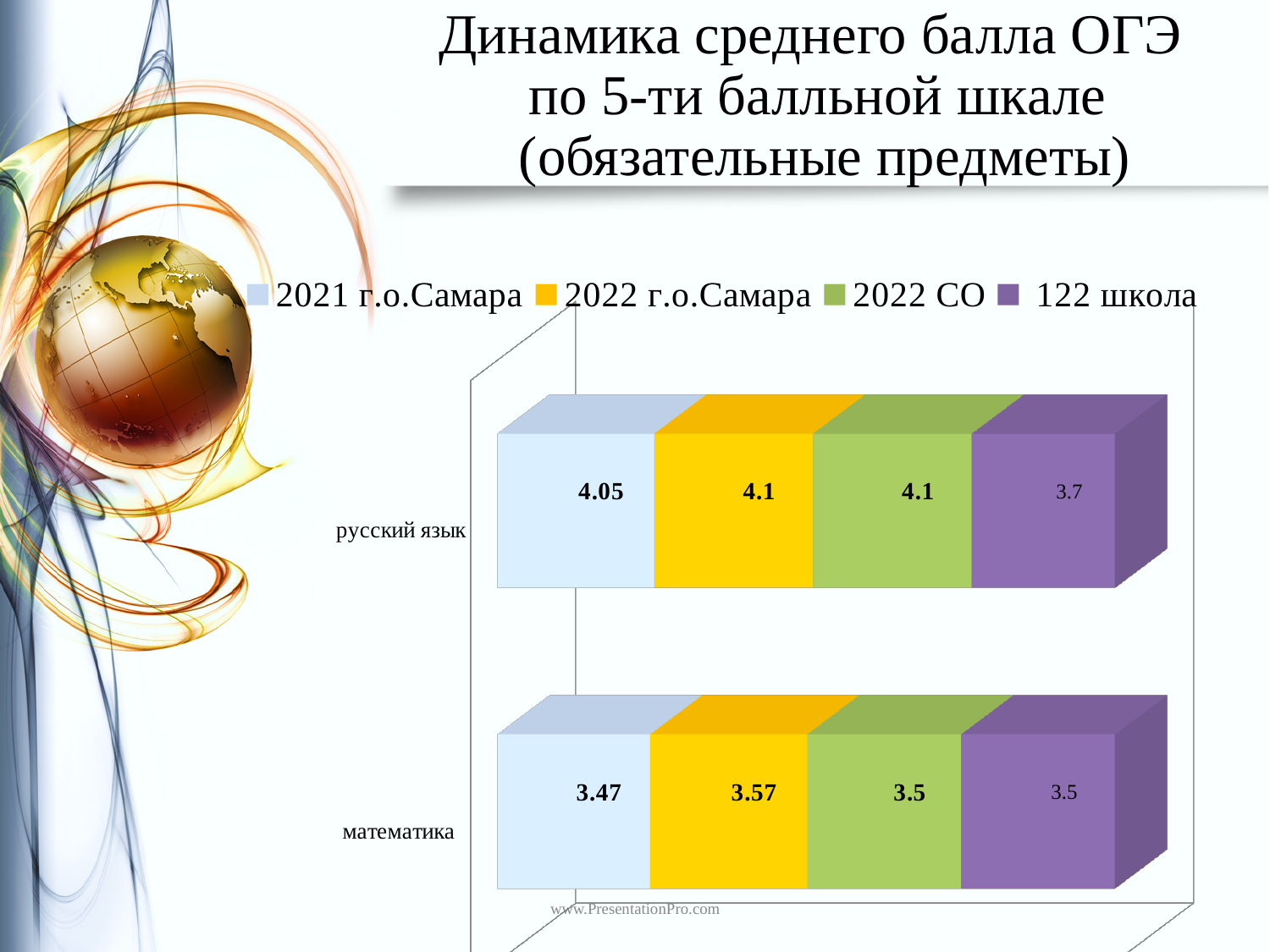
Which series has the lowest value for русский язык? 122 школа How many series does the legend list? 4 What is the difference between the 2022 СО and 122 школа values for русский язык? 0.4 How many subject categories are shown on the chart? 2 What is the value for 2022 г.о.Самара for математика? 3.57 What is the value for 122 школа for русский язык? 3.7 Which series has the highest value for математика? 2022 г.о.Самара What kind of chart is shown on the slide? Bar chart Which is larger for русский язык: the 2021 г.о.Самара value or the 122 школа value? 2021 г.о.Самара What is the value for 2021 г.о.Самара for русский язык? 4.05 What is the value for 2022 СО for математика? 3.5 What is the difference between the 2022 г.о.Самара and 2021 г.о.Самара values for математика? 0.1